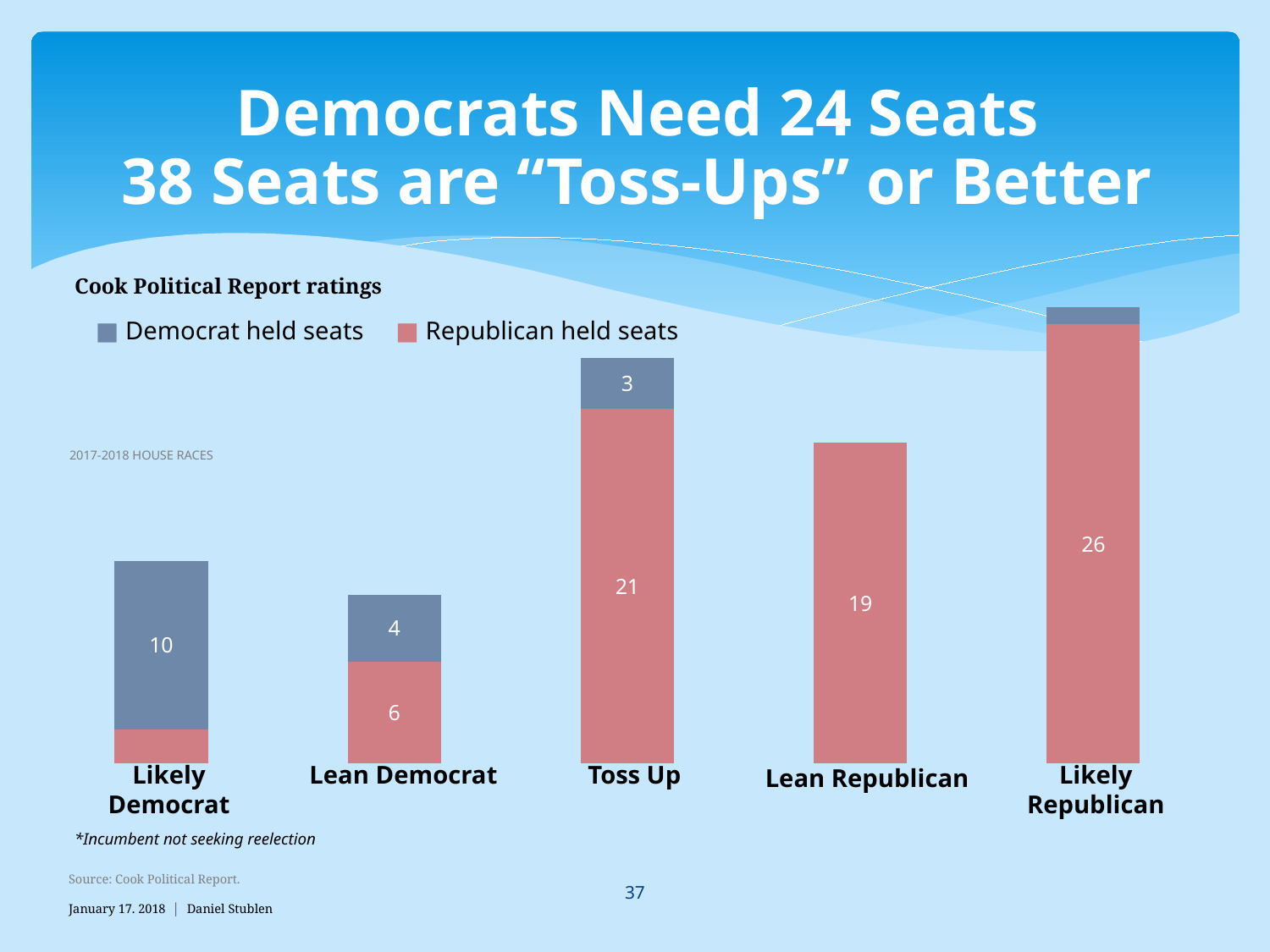
What kind of chart is shown on the slide? Stacked bar chart How many categories are shown on the x axis of the chart? 5 Which category has more Republican held seats, Toss Up or Lean Republican? Toss Up What is the difference between Republican held seats in Likely Republican and Lean Republican? 7 How many Democrat held seats are in the Toss Up category? 3 How many series does the legend list? 2 How many Republican held seats are in the Toss Up category? 21 What is the total number of seats in the Lean Democrat bar? 10 How many Republican held seats are in the Lean Republican category? 19 What is the total number of seats in the Toss Up bar? 24 How many Democrat held seats are in the Likely Democrat category? 10 How many Republican held seats are in the Likely Republican category? 26